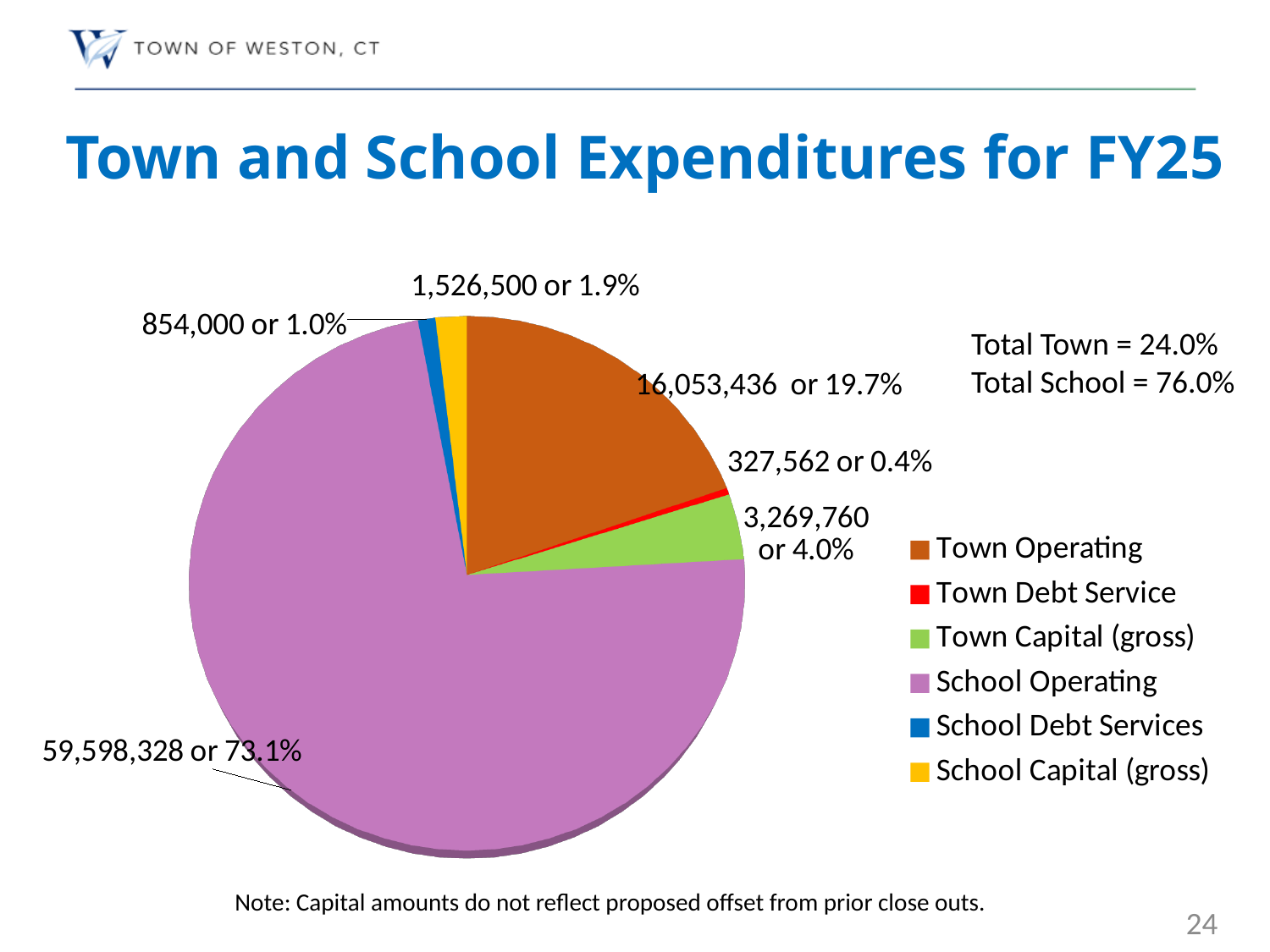
Which is larger, Town Capital (gross) or School Capital (gross)? Town Capital (gross) What kind of chart is shown on the slide? Pie chart What is the value shown for School Operating? 59,598,328 or 73.1% What is the value shown for Town Capital (gross)? 3,269,760 or 4.0% Which category is the largest slice of the pie? School Operating Which category is the smallest slice of the pie? Town Debt Service How many slices does the pie chart have? 6 What is the title of the chart on the slide? Town and School Expenditures for FY25 What share of the pie does School Debt Services represent? 1.0% What is the value shown for Town Operating? 16,053,436 or 19.7% What share of the pie does School Capital (gross) represent? 1.9% What is the value shown for Town Debt Service? 327,562 or 0.4%